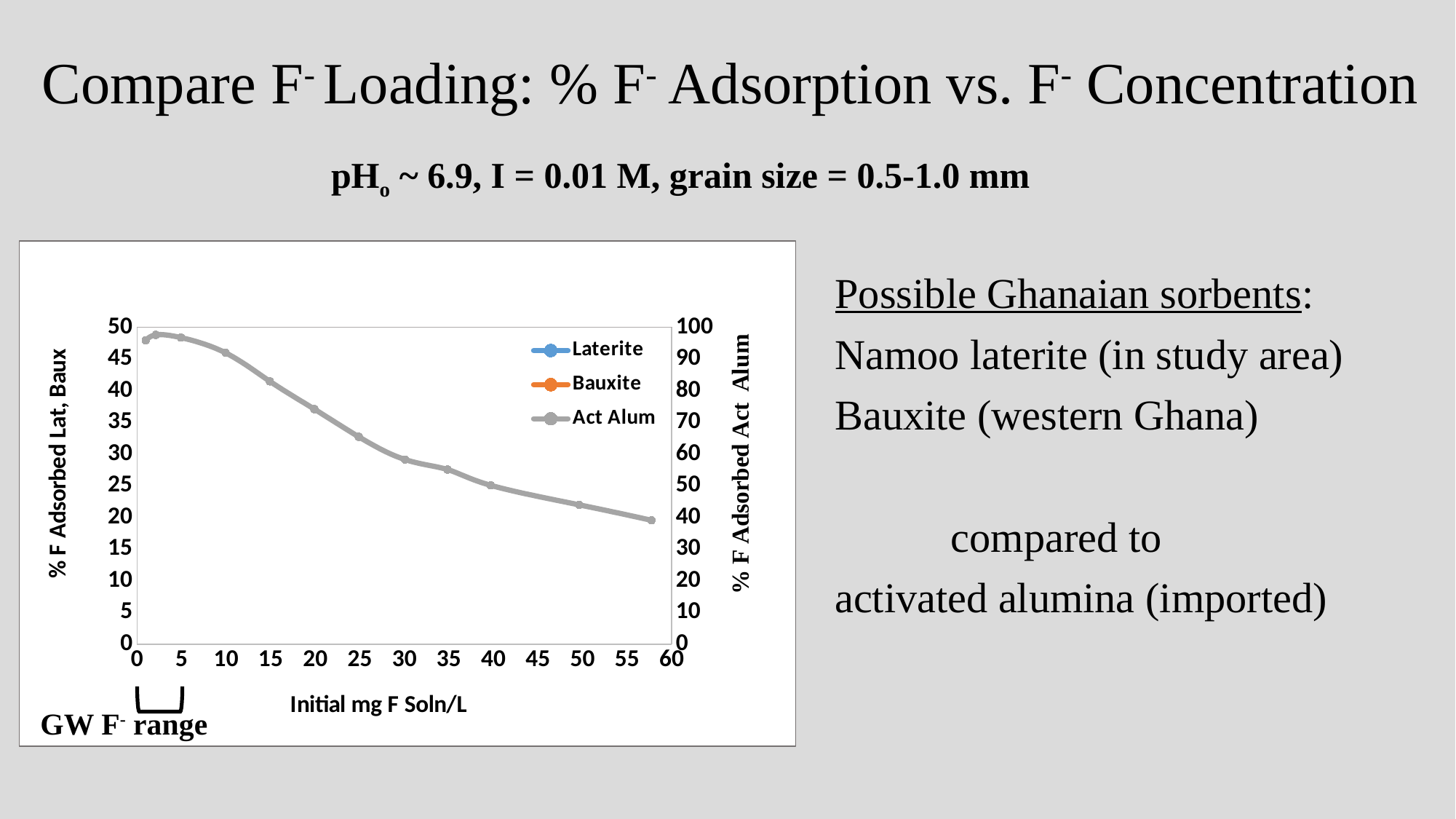
On the right axis, is the Act Alum value at 30 mg F/L greater or less than 50? greater Does the Act Alum line rise or fall as the initial F concentration increases from 5 to 60 mg/L? fall What is the title of the x axis of the chart? Initial mg F Soln/L On the right axis, is the Act Alum value at 50 mg F/L greater or less than 40? greater Is the Act Alum value at 10 mg F/L larger or smaller than its value at 40 mg F/L? larger How many series does the chart legend list? 3 Which series are listed in the chart legend? Laterite, Bauxite, Act Alum On the right axis, is the Act Alum value at 20 mg F/L greater or less than 70? greater What kind of chart is shown on the slide? line chart